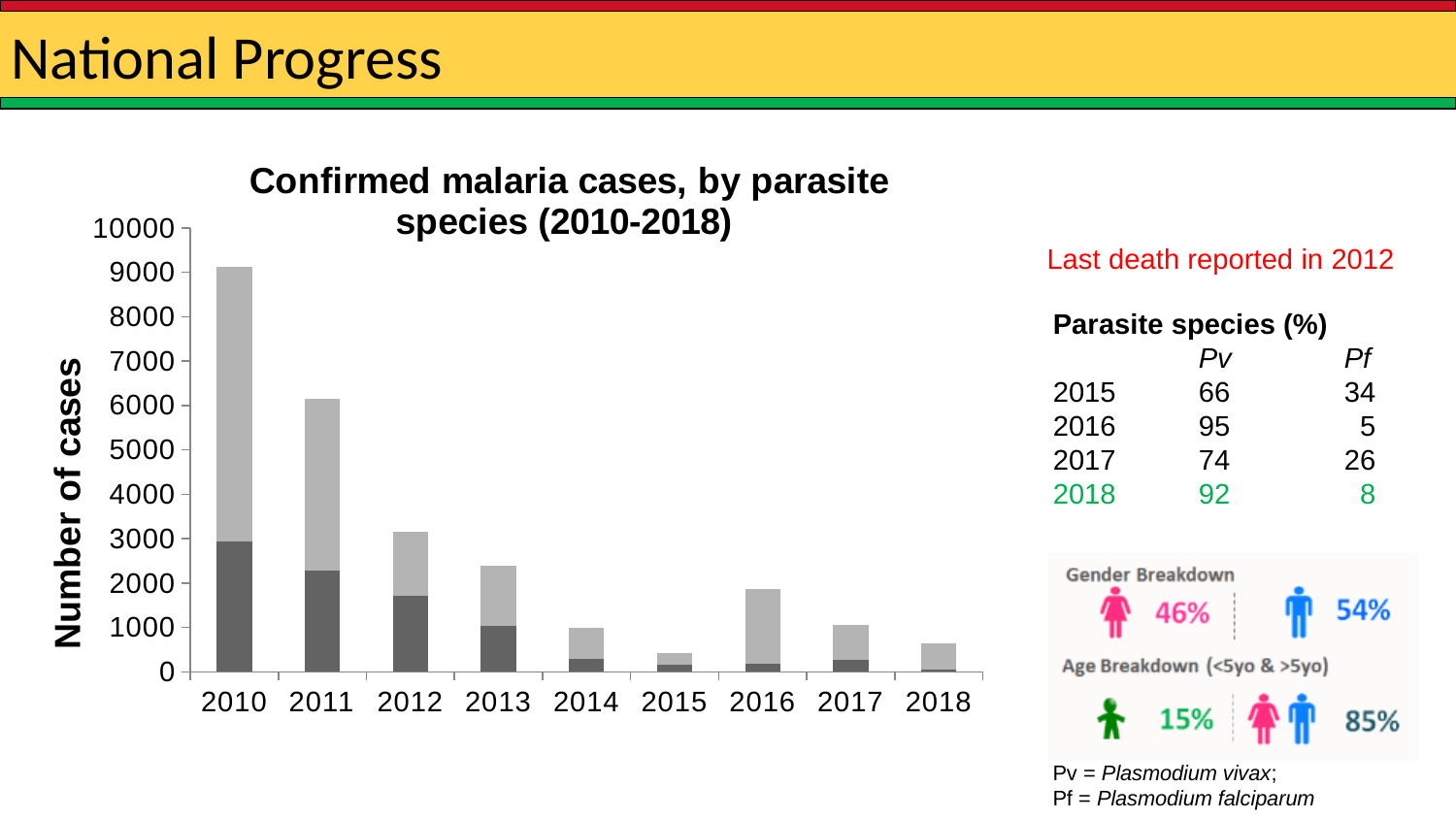
How many years are shown on the x axis of the chart? 9 Which year has the lowest total number of confirmed malaria cases? 2015 Which year has more total confirmed cases, 2016 or 2017? 2016 Is the total number of cases in 2018 greater or less than 1000? less What kind of chart is shown on the slide? Bar chart Is the total number of cases in 2015 greater or less than 1000? less Is the total number of cases in 2013 greater or less than 2000? greater What is the title of the chart? Confirmed malaria cases, by parasite species (2010-2018) Which year has the highest total number of confirmed malaria cases? 2010 Do the total confirmed malaria cases generally rise or fall from 2010 to 2018? fall